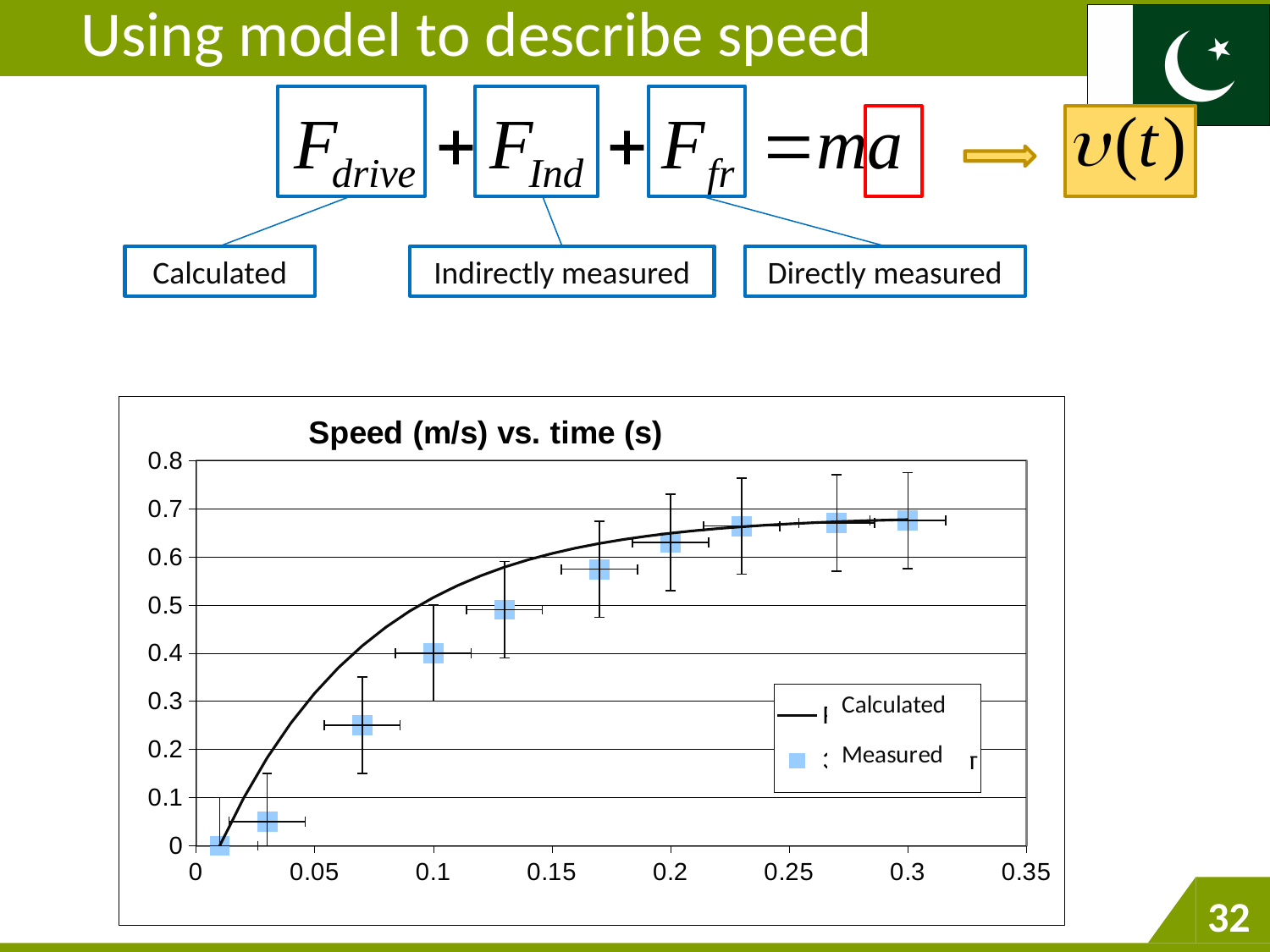
How many measured data points are plotted on the chart? 10 What is the highest value shown on the chart's y axis? 0.8 Which is larger, the measured speed at time 0.1 s or at time 0.2 s? 0.2 s Is the calculated speed at time 0.3 s greater or less than 0.7? less How many series does the chart's legend list? 2 Is the measured speed at time 0.1 s greater or less than 0.3? greater Is the measured speed at time 0.07 s greater or less than 0.3? less What is the title of the chart on the slide? Speed (m/s) vs. time (s) What are the two series named in the chart's legend? Calculated and Measured Does the speed rise or fall as time increases along the x axis? Rise What kind of chart is shown on the slide? Scatter chart with a fitted line